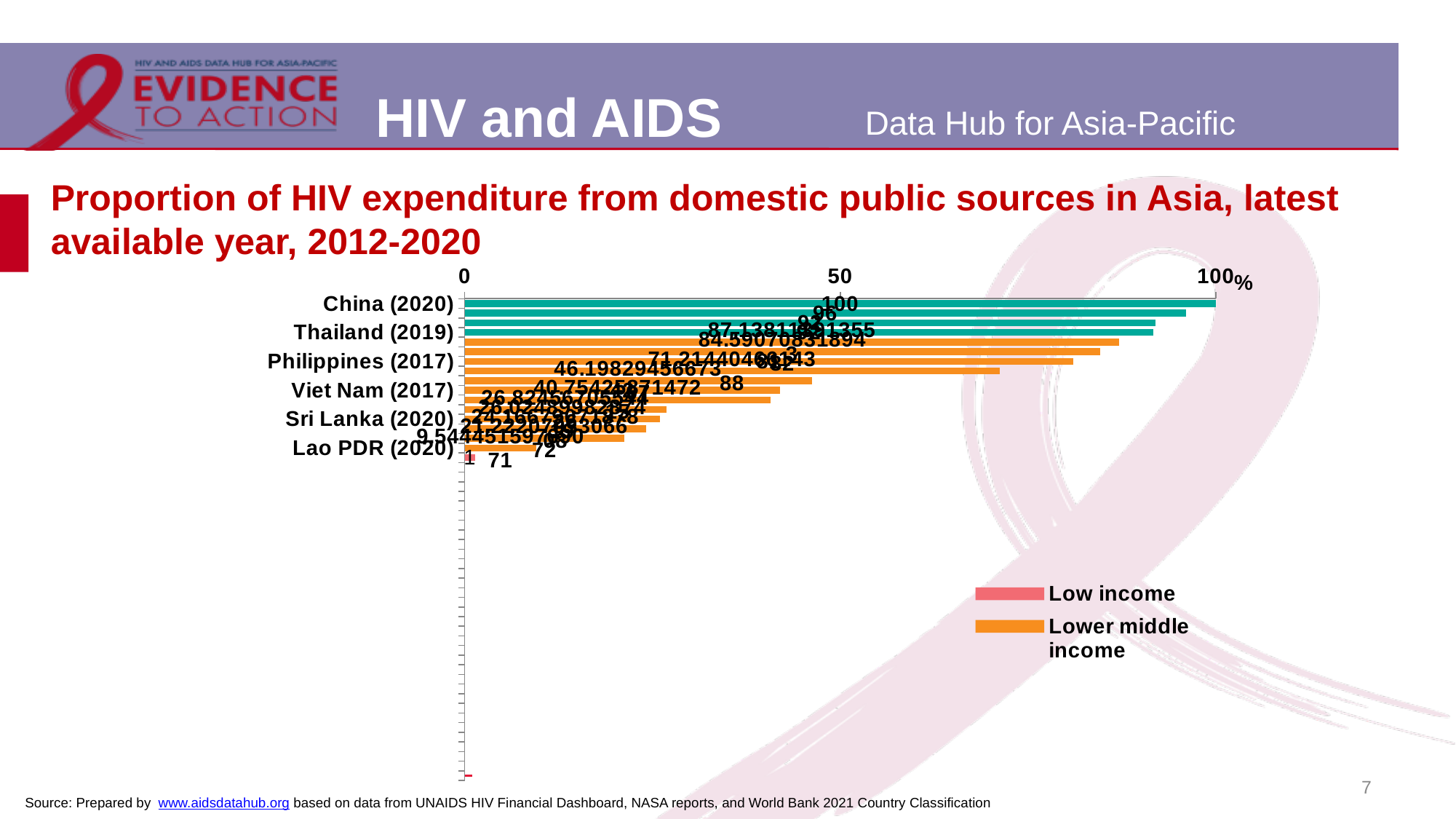
What is the value for China (2020)? 100 What colour does the legend use for the Lower middle income series? orange Is the value for Philippines (2017) greater or less than 50? greater Which is larger, the value for Thailand (2019) or the value for Sri Lanka (2020)? Thailand (2019) Is the value for Sri Lanka (2020) greater or less than 50? less Is the value for Thailand (2019) greater or less than 50? greater How many series does the legend list? 2 Which country has the highest proportion of HIV expenditure from domestic public sources? China (2020) Do the bar values increase or decrease going from the top of the chart to the bottom? decrease What kind of chart is shown on the slide? bar chart Which is larger, the value for China (2020) or the value for Lao PDR (2020)? China (2020)